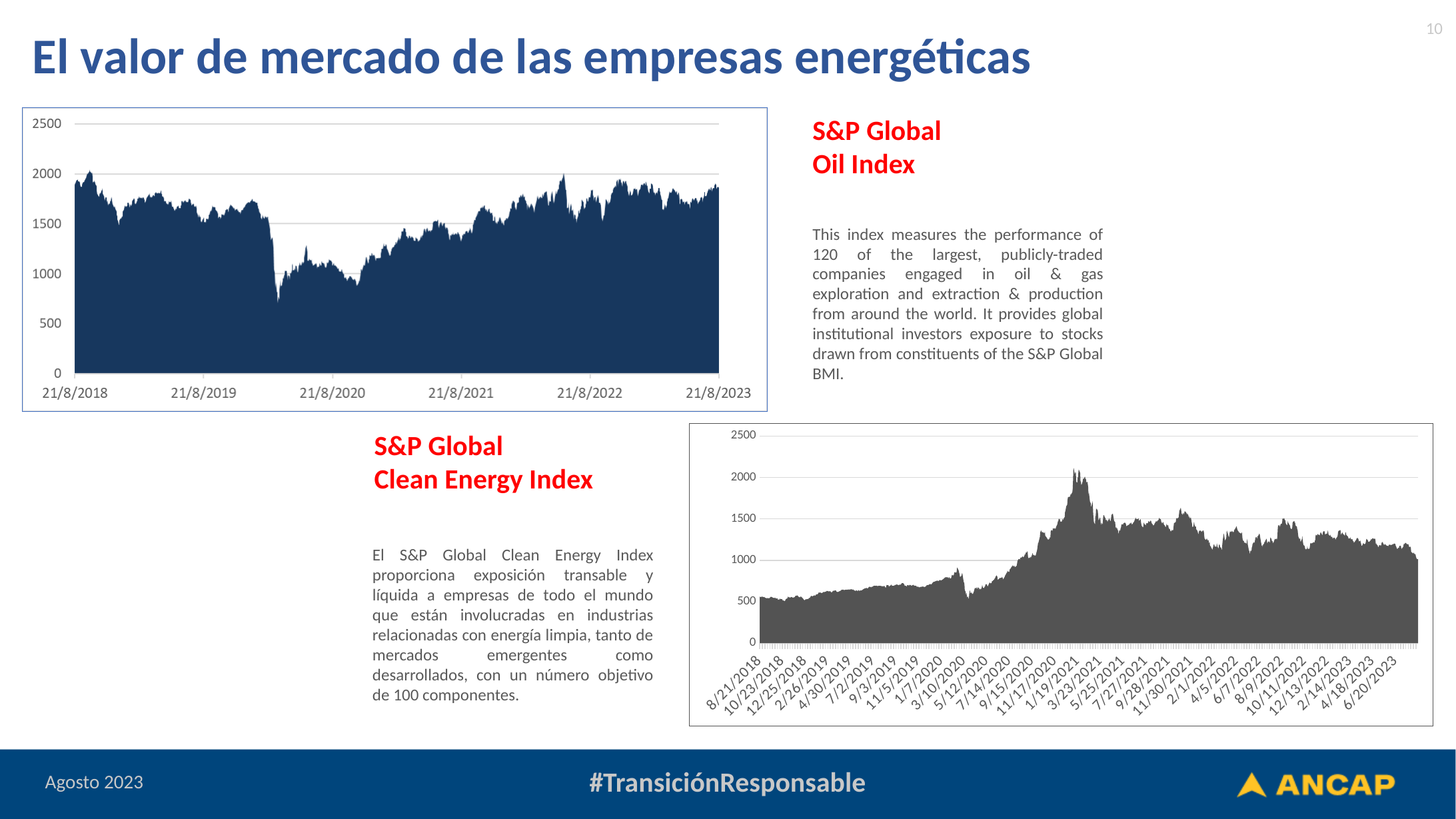
What is the highest value shown on the y axis of the S&P Global Clean Energy Index chart? 2500 In the S&P Global Clean Energy Index chart, does the index rise or fall between 8/21/2018 and 1/19/2021? rise What is the first date label on the x axis of the S&P Global Oil Index chart? 21/8/2018 In the S&P Global Clean Energy Index chart, is the peak value (around 1/19/2021) greater or less than 2000? greater How many date labels are shown on the x axis of the S&P Global Oil Index chart? 6 In the S&P Global Oil Index chart, is the lowest point of the series (around early 2020) greater or less than 1000? less In the S&P Global Oil Index chart, does the index rise or fall between 21/8/2019 and 21/8/2020? fall In the S&P Global Clean Energy Index chart, is the value at 8/21/2018 greater or less than 1000? less What kind of chart is the S&P Global Clean Energy Index chart (bottom right)? area chart What kind of chart is the S&P Global Oil Index chart (top left)? area chart